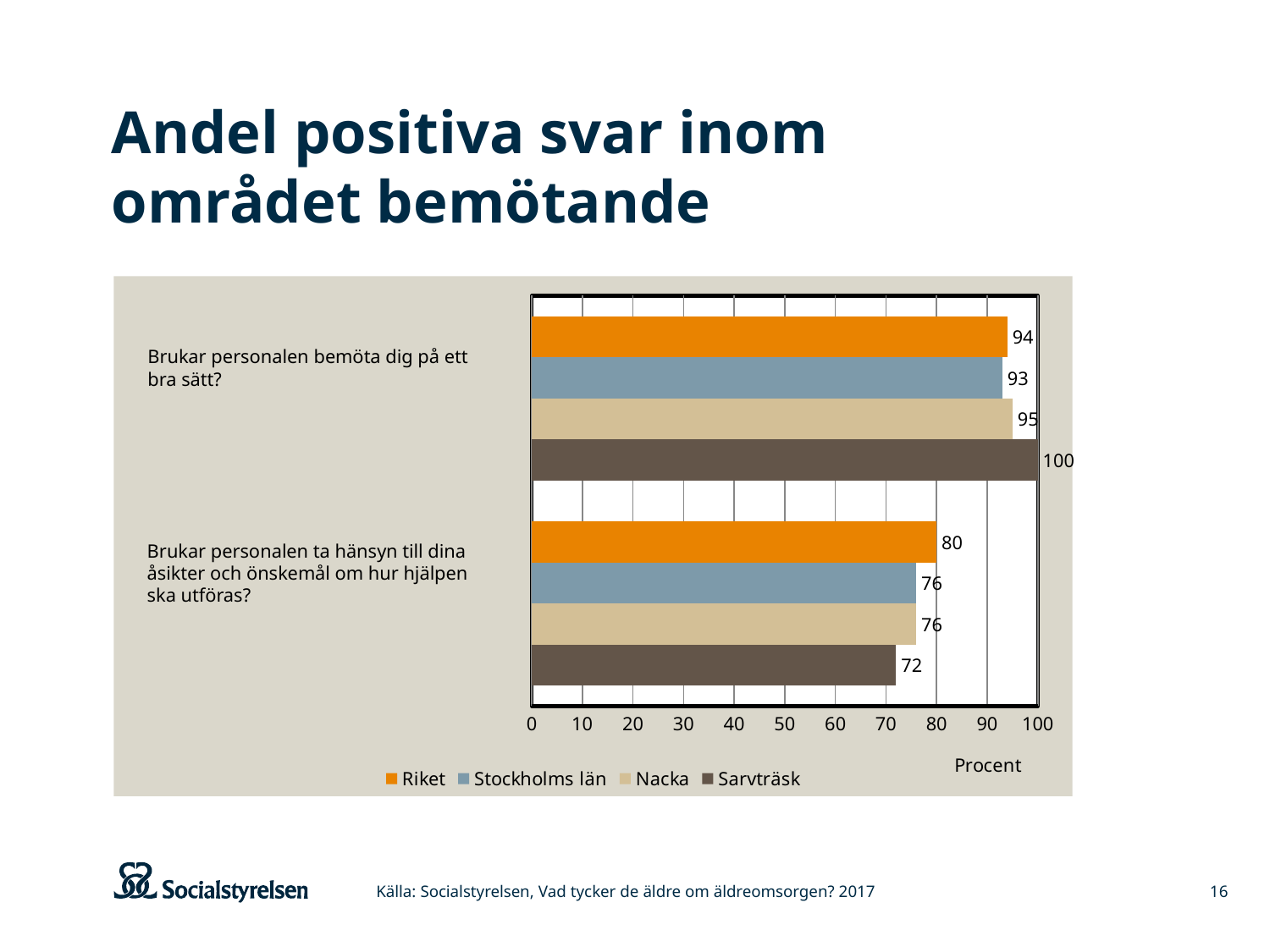
What is the value for Stockholms län on the question "Brukar personalen bemöta dig på ett bra sätt?"? 93 How many series does the legend list? 4 Which series has the highest value on the question "Brukar personalen bemöta dig på ett bra sätt?"? Sarvträsk Which is larger on the question "Brukar personalen bemöta dig på ett bra sätt?": the value for Riket or the value for Nacka? Nacka How many questions (categories) are shown on the chart? 2 What is the value for Sarvträsk on the question "Brukar personalen bemöta dig på ett bra sätt?"? 100 What kind of chart is shown on the slide? Bar chart What is the difference between the Riket value and the Sarvträsk value on the question "Brukar personalen ta hänsyn till dina åsikter och önskemål om hur hjälpen ska utföras?"? 8 Which series has the lowest value on the question "Brukar personalen ta hänsyn till dina åsikter och önskemål om hur hjälpen ska utföras?"? Sarvträsk What is the value for Nacka on the question "Brukar personalen ta hänsyn till dina åsikter och önskemål om hur hjälpen ska utföras?"? 76 What is the label of the horizontal axis? Procent What is the value for Riket on the question "Brukar personalen ta hänsyn till dina åsikter och önskemål om hur hjälpen ska utföras?"? 80